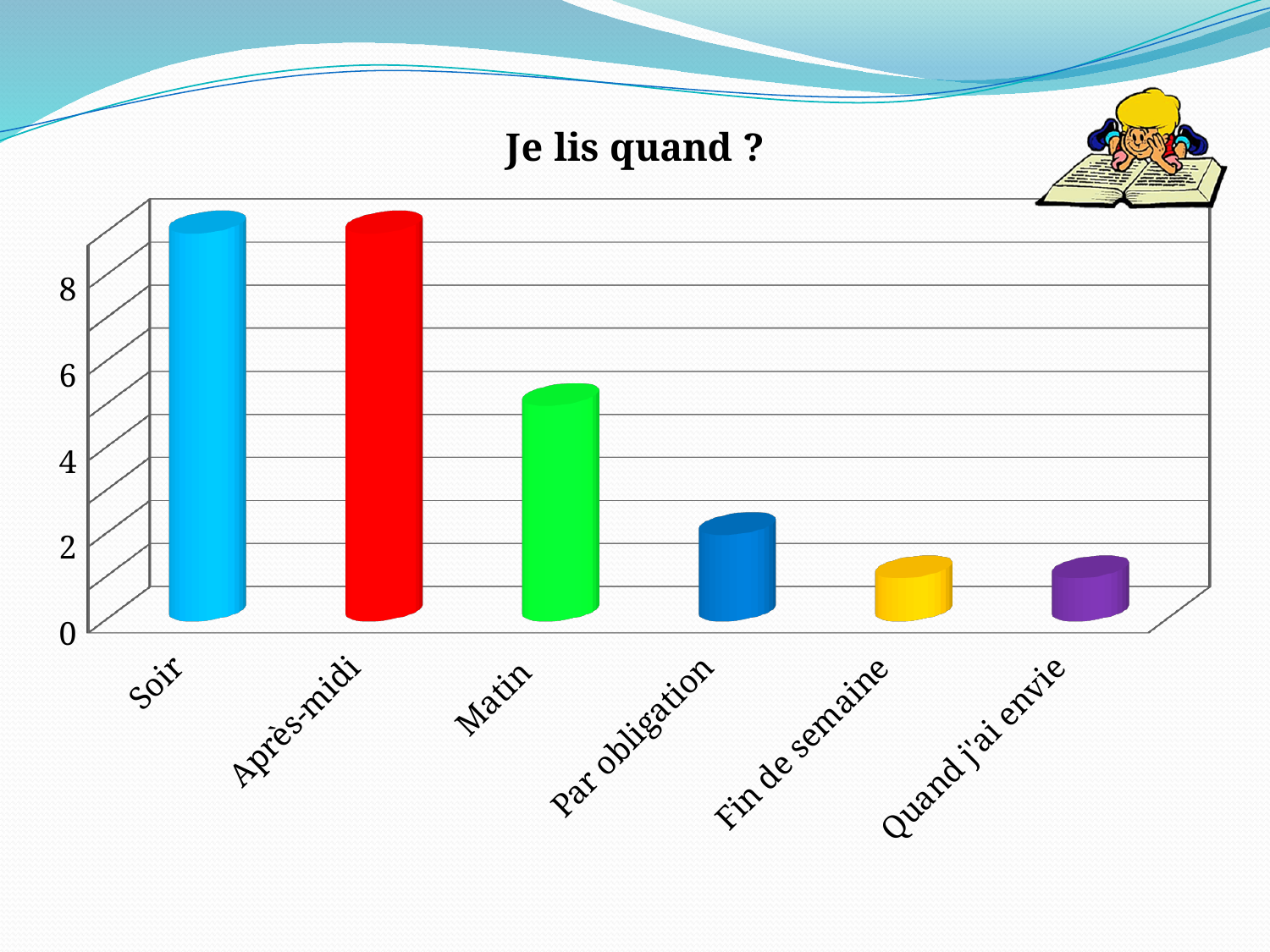
Is the value for Par obligation greater or less than 4? less What kind of chart is shown on the slide? bar chart What colour is the bar for Matin? green Is the value for Fin de semaine greater or less than 2? less How many categories are shown on the x axis of the chart? 6 Is the value for Matin greater or less than 6? less What is the title of the chart? Je lis quand ? Which is larger, the value for Matin or the value for Par obligation? Matin Which is larger, the value for Après-midi or the value for Fin de semaine? Après-midi Do the values generally rise or fall from left to right along the x axis? fall